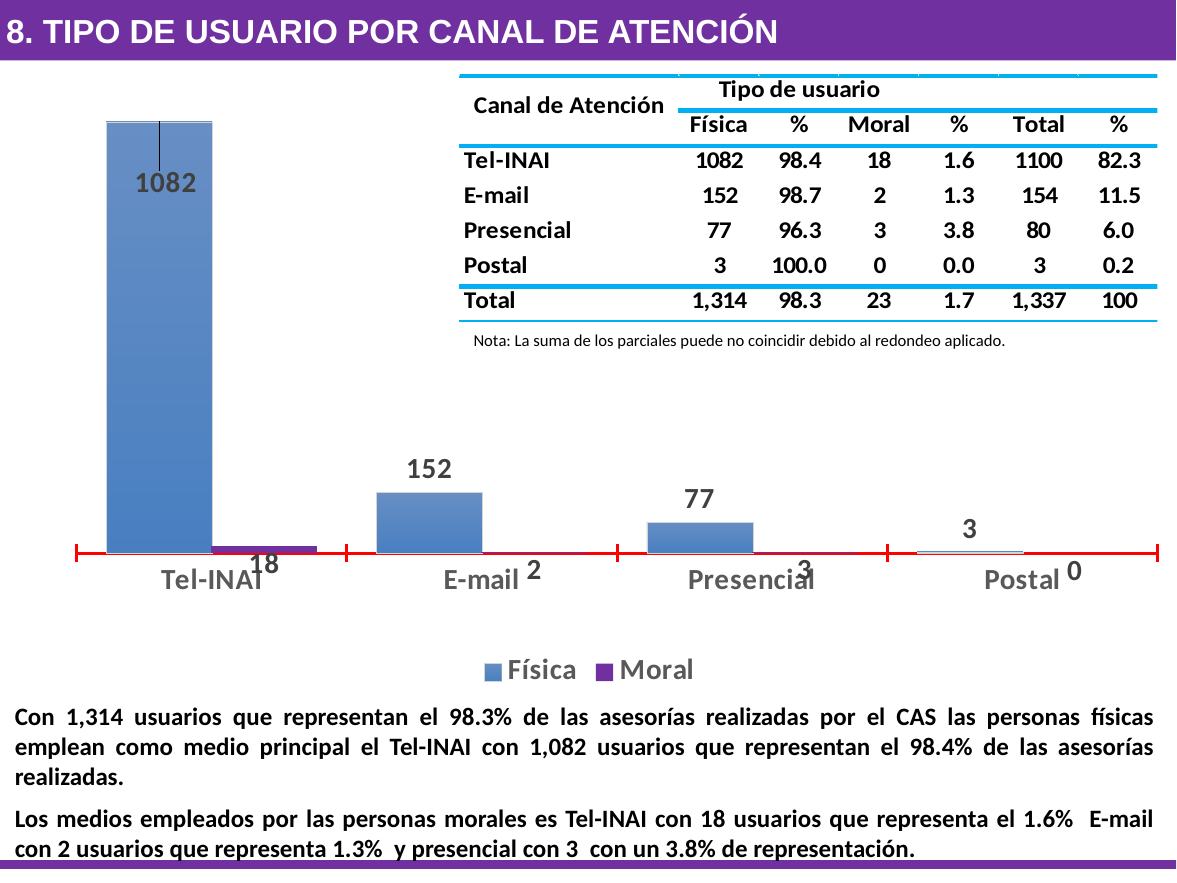
What kind of chart is shown on the slide? bar chart What is the difference between the Física values for Tel-INAI and E-mail? 930 What is the value for Física in the Presencial category? 77 What is the value for Física in the Tel-INAI category? 1082 What is the value for Moral in the Postal category? 0 Which category has the lowest Física value? Postal How many categories are shown on the x axis of the chart? 4 Which is larger, the Moral value for Tel-INAI or the Moral value for Presencial? Tel-INAI What is the value for Moral in the E-mail category? 2 How many series does the chart legend list? 2 Do the Física values rise or fall from Tel-INAI to Postal along the x axis? fall Which category has the highest Física value? Tel-INAI